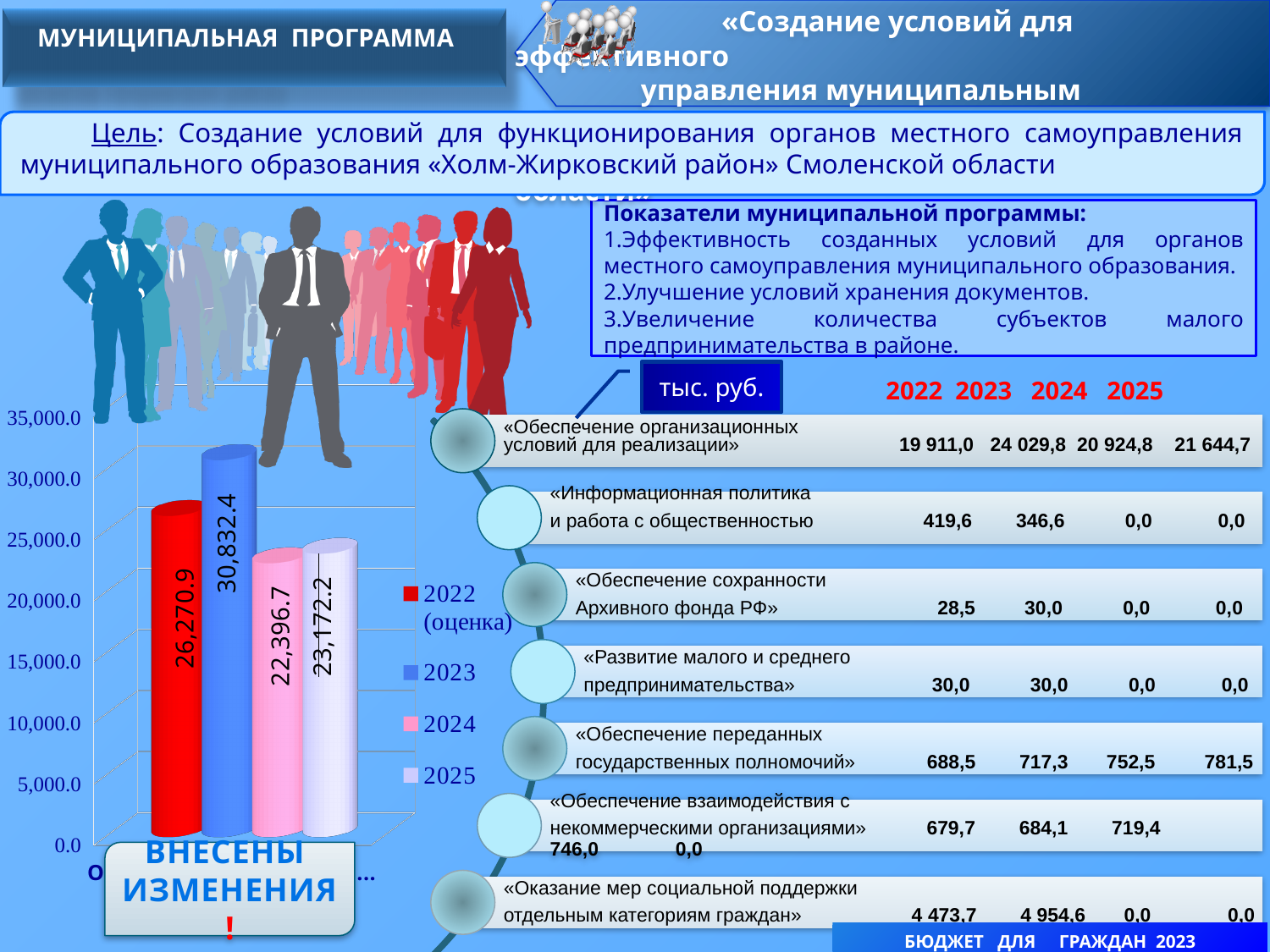
What value is shown for 2022 (оценка) on the bar chart? 26,270.9 What value is shown for 2025 on the bar chart? 23,172.2 What value is shown for 2023 on the bar chart? 30,832.4 How many entries does the legend of the bar chart list? 4 What is the difference between the 2023 and 2022 (оценка) values on the bar chart? 4,561.5 Which year has the lowest value on the bar chart? 2024 What value is shown for 2024 on the bar chart? 22,396.7 How many bars are plotted on the bar chart? 4 Which year has the highest value on the bar chart? 2023 What kind of chart is shown on the left of the slide? Bar chart What is the difference between the 2025 and 2024 values on the bar chart? 775.5 Which is larger on the bar chart, the value for 2022 (оценка) or the value for 2025? 2022 (оценка)